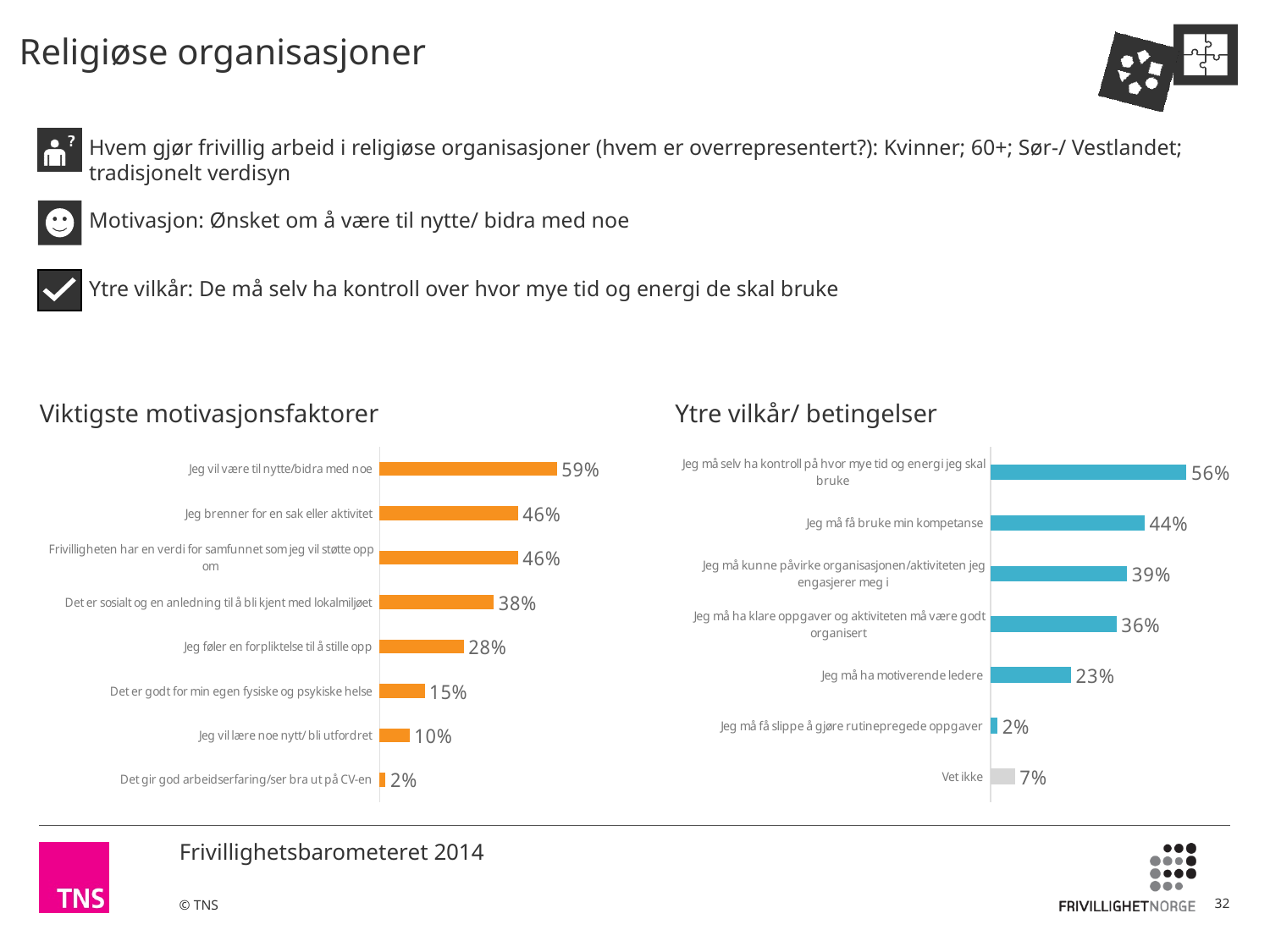
How many categories are shown in the 'Viktigste motivasjonsfaktorer' chart? 8 How many categories are shown in the 'Ytre vilkår/ betingelser' chart? 7 In the 'Ytre vilkår/ betingelser' chart, which is larger: 'Jeg må kunne påvirke organisasjonen/aktiviteten jeg engasjerer meg i' or 'Jeg må ha klare oppgaver og aktiviteten må være godt organisert'? Jeg må kunne påvirke organisasjonen/aktiviteten jeg engasjerer meg i What kind of chart is the 'Ytre vilkår/ betingelser' chart? Bar chart In the 'Viktigste motivasjonsfaktorer' chart, what is the difference between 'Jeg vil være til nytte/bidra med noe' and 'Jeg brenner for en sak eller aktivitet'? 13 percentage points In the 'Viktigste motivasjonsfaktorer' chart, which is larger: 'Det er sosialt og en anledning til å bli kjent med lokalmiljøet' or 'Jeg føler en forpliktelse til å stille opp'? Det er sosialt og en anledning til å bli kjent med lokalmiljøet In the 'Viktigste motivasjonsfaktorer' chart, what is the value for 'Jeg vil være til nytte/bidra med noe'? 59% In the 'Viktigste motivasjonsfaktorer' chart, which category has the lowest value? Det gir god arbeidserfaring/ser bra ut på CV-en In the 'Ytre vilkår/ betingelser' chart, which category has the highest value? Jeg må selv ha kontroll på hvor mye tid og energi jeg skal bruke In the 'Ytre vilkår/ betingelser' chart, what is the value for 'Jeg må få bruke min kompetanse'? 44% In the 'Ytre vilkår/ betingelser' chart, what is the difference between 'Jeg må ha motiverende ledere' and 'Vet ikke'? 16 percentage points In the 'Viktigste motivasjonsfaktorer' chart, what is the value for 'Jeg vil lære noe nytt/ bli utfordret'? 10%